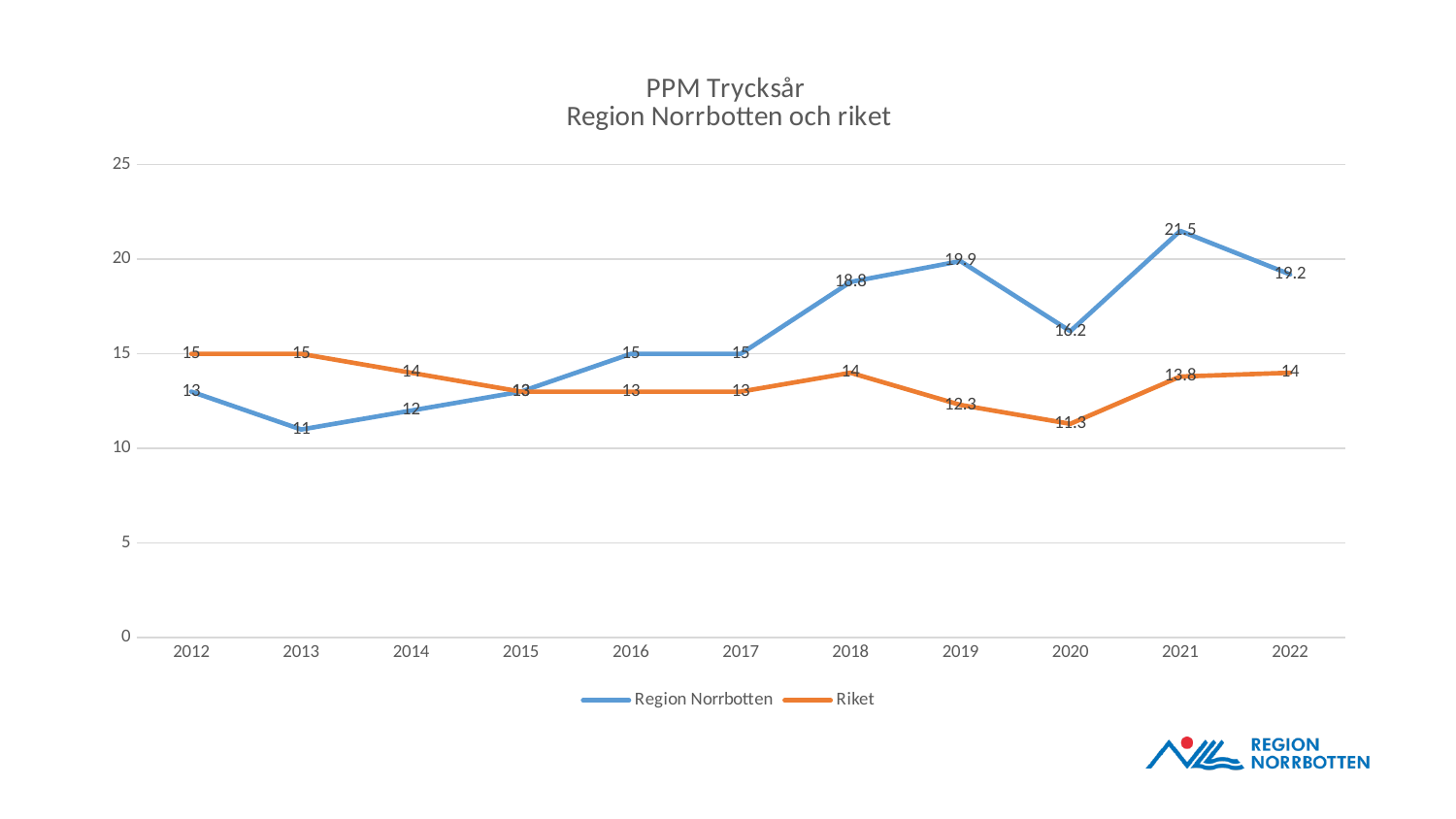
How many series does the legend list? 2 What is the difference between Region Norrbotten and Riket in 2022? 5.2 Is the value for Region Norrbotten in 2019 greater or less than 15? greater What is the title of the chart? PPM Trycksår Region Norrbotten och riket Which series has the higher value in 2013, Region Norrbotten or Riket? Riket What type of chart is shown on the slide? line chart In which year does Region Norrbotten reach its highest value? 2021 How many years are plotted along the x axis? 11 What is the value for Riket in 2020? 11.3 In which year does Region Norrbotten have its lowest value? 2013 What is the value for Region Norrbotten in 2018? 18.8 What is the value for Region Norrbotten in 2021? 21.5